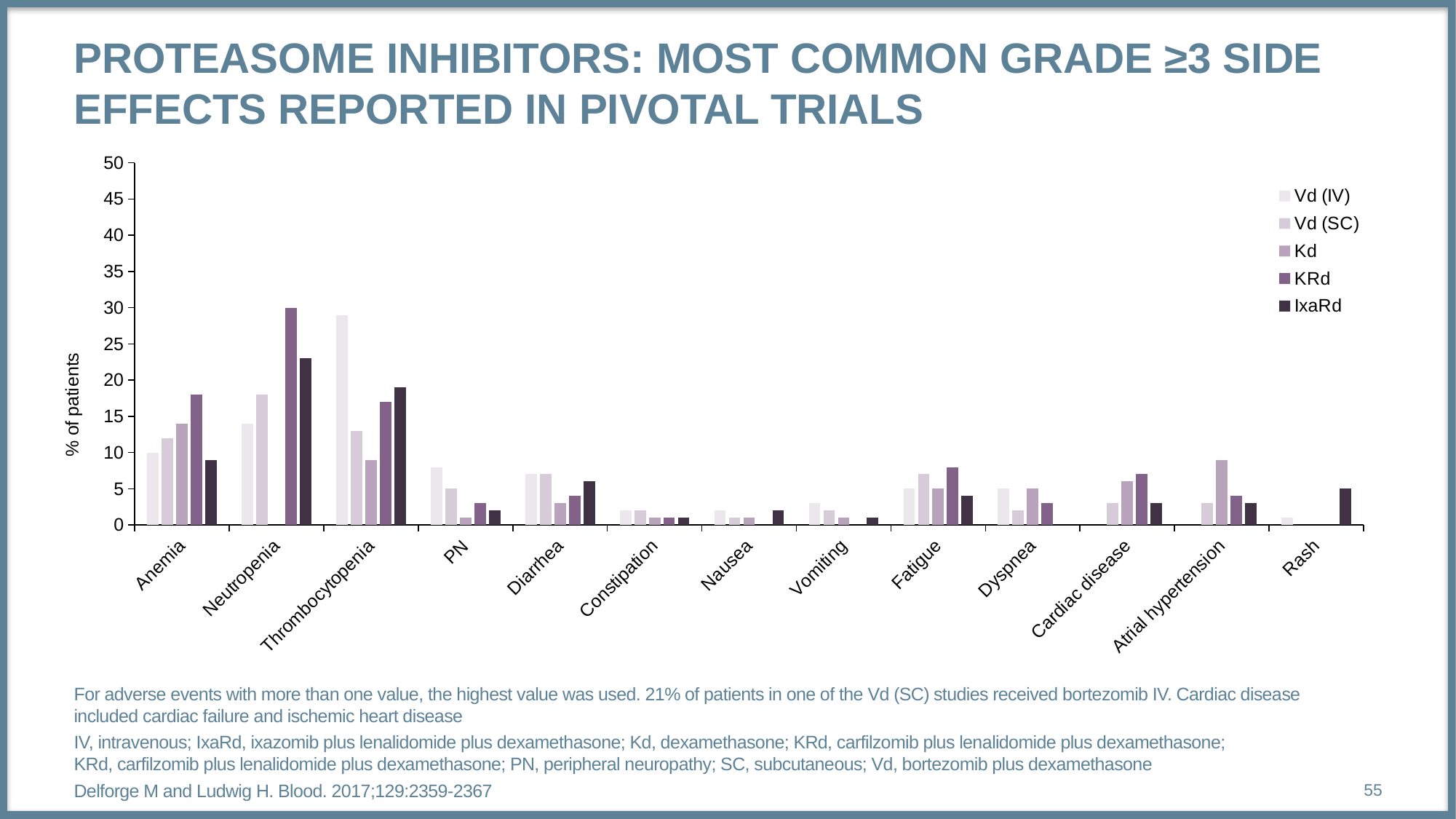
Is the value for IxaRd in Neutropenia greater or less than 20? greater For Thrombocytopenia, which is larger: the Vd (IV) value or the Kd value? Vd (IV) What is the label on the y axis of the chart? % of patients For Anemia, which is larger: the KRd value or the IxaRd value? KRd Is the value for KRd in Neutropenia greater or less than 25? greater How many side-effect categories are shown on the x axis? 13 Is the value for Vd (IV) in Thrombocytopenia greater or less than 25? greater How many series does the legend list? 5 Which series has the highest value for Thrombocytopenia? Vd (IV) What kind of chart is shown on the slide? bar chart Which series has the highest value for Atrial hypertension? Kd Which series has the highest value for Neutropenia? KRd